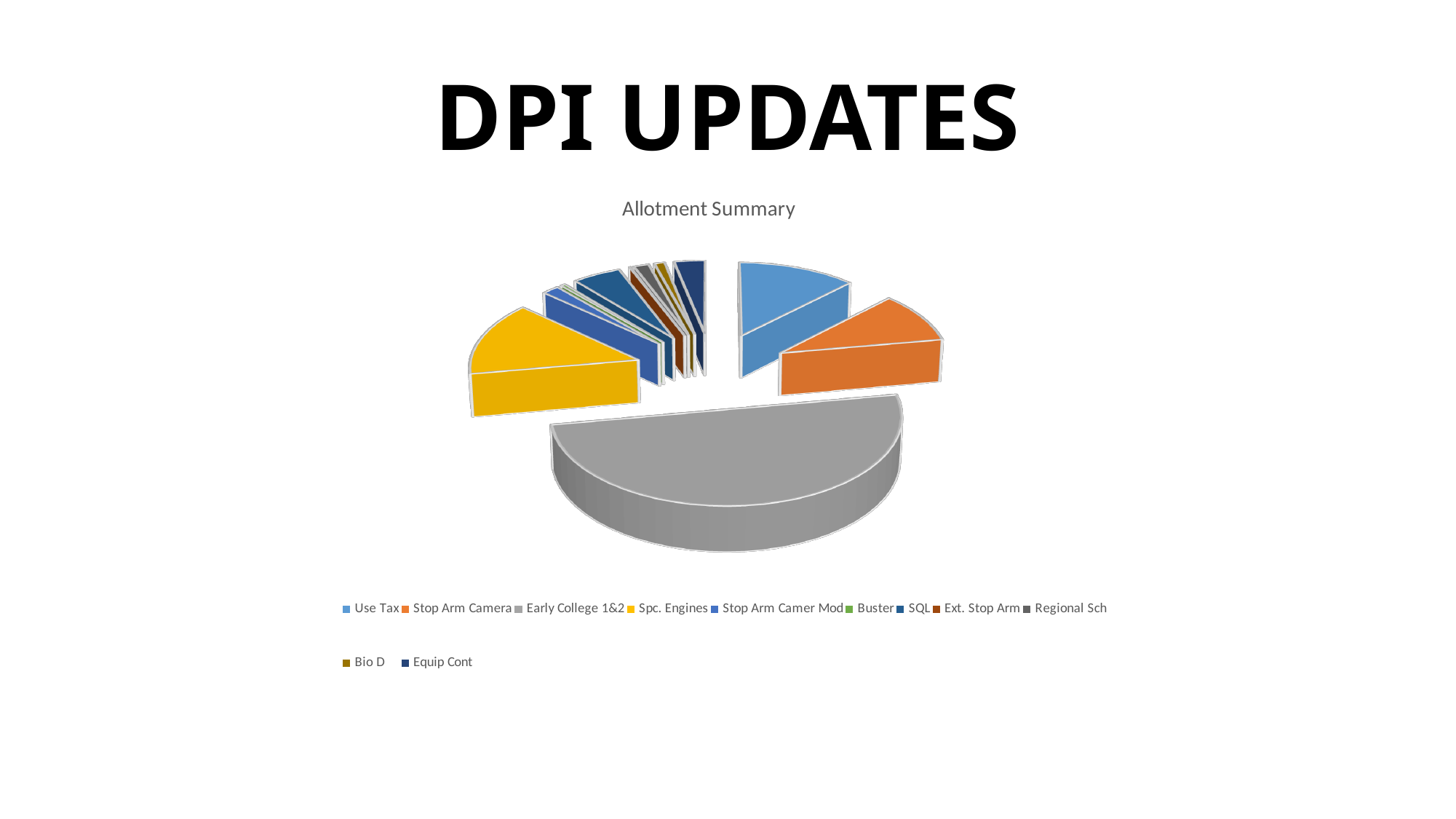
Which category has the largest slice of the pie? Early College 1&2 How many categories does the legend of the pie chart list? 11 Which is larger, the slice for Early College 1&2 or the slice for Stop Arm Camera? Early College 1&2 What is the title of the chart? Allotment Summary Which category is shown in gray in the pie chart? Early College 1&2 What kind of chart is shown on the slide? pie chart Which is larger, the slice for Spc. Engines or the slice for Buster? Spc. Engines Which is larger, the slice for Early College 1&2 or the slice for Use Tax? Early College 1&2